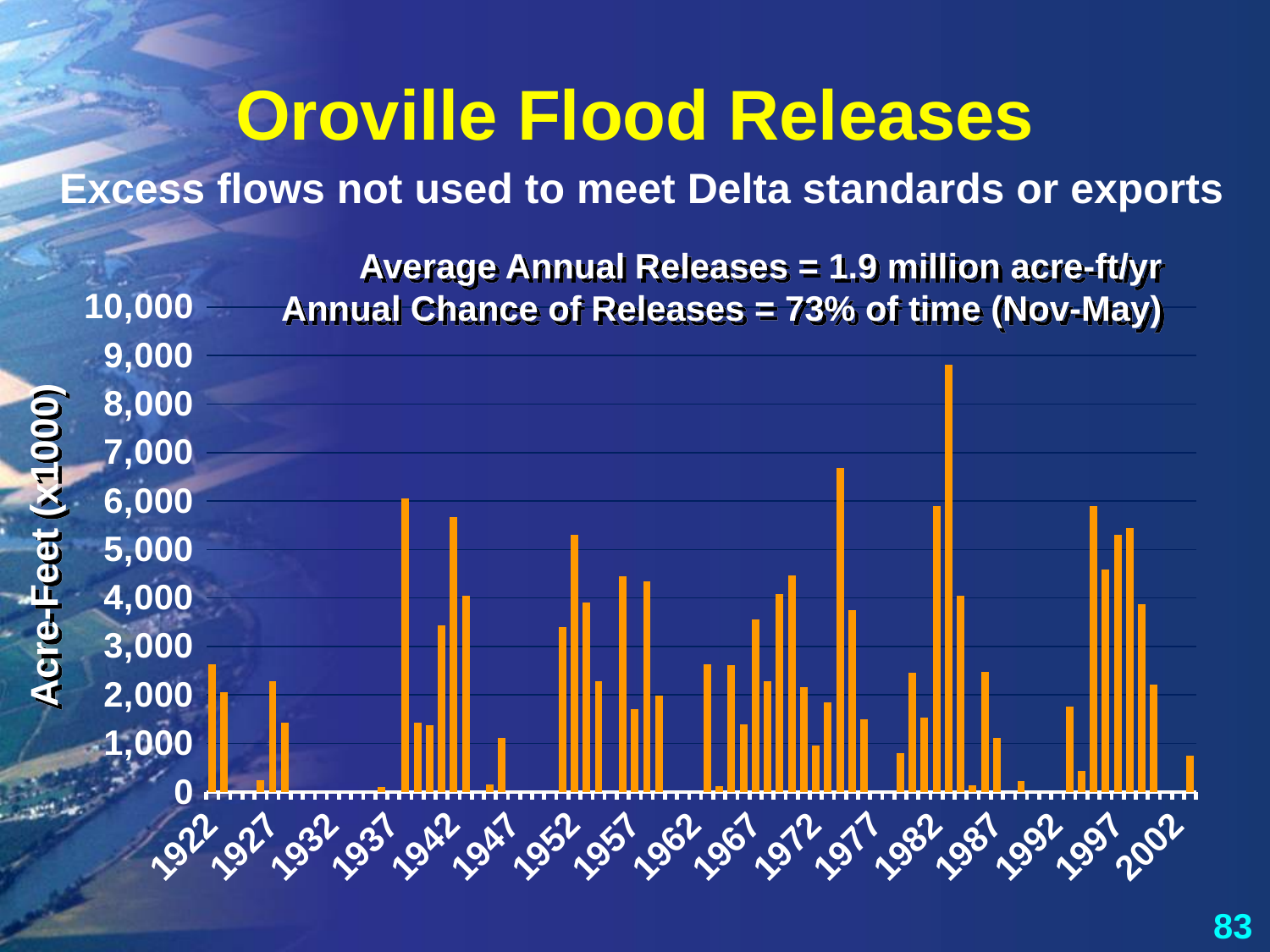
Is the value for the last year shown (2002) greater or less than 1,000? less How many data series are plotted on the chart? 1 How many year labels are printed along the horizontal axis? 17 What is the label on the vertical axis of the chart? Acre-Feet (x1000) Is the value for the first year shown (1922) greater or less than 2,000? greater Is the value for the first year shown (1922) greater or less than 3,000? less What is the highest value printed on the vertical axis? 10,000 What is the first year label on the horizontal axis? 1922 What kind of chart is shown on the slide? bar chart According to the annotation on the chart, what is the average annual release? 1.9 million acre-ft/yr